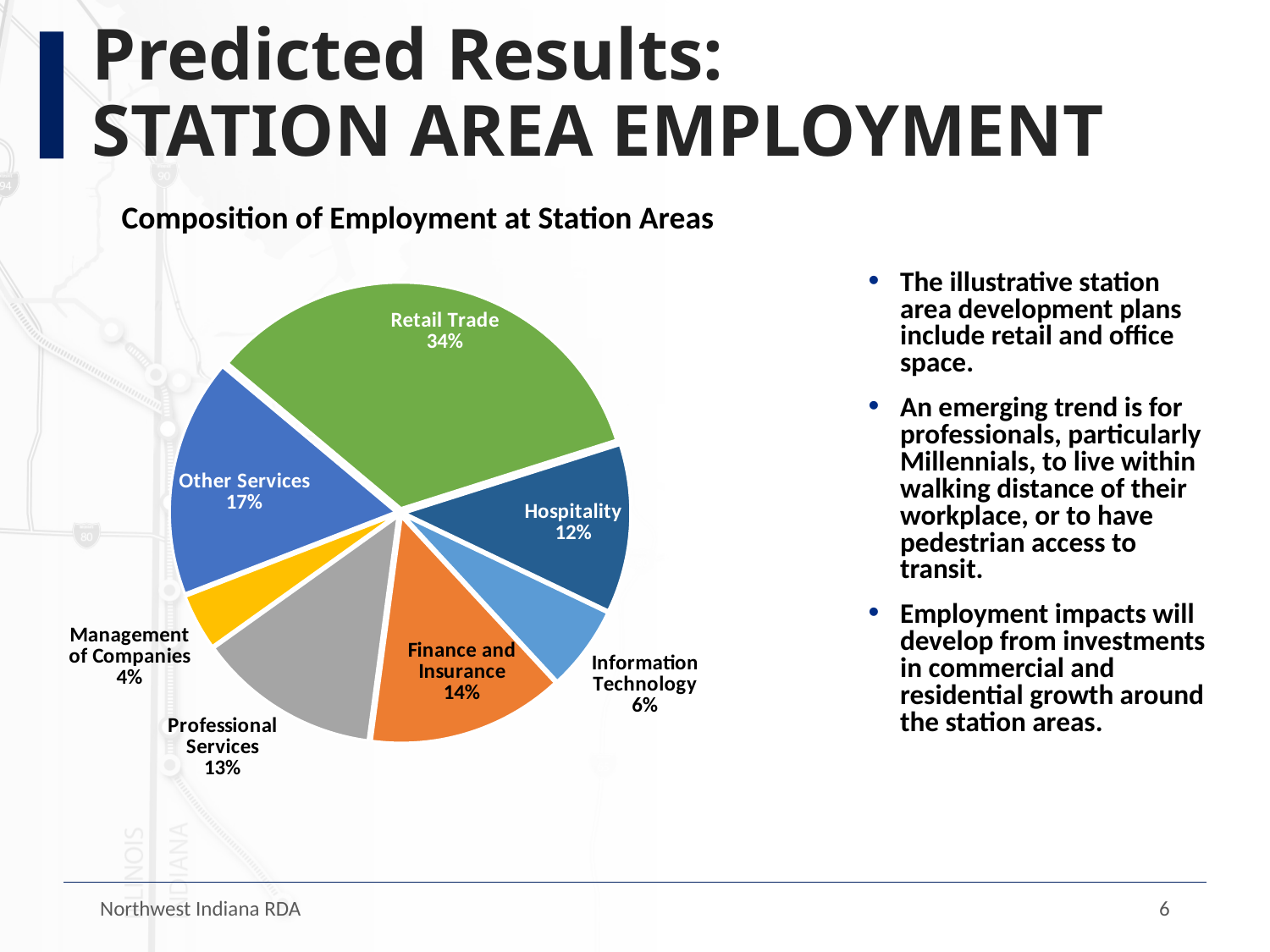
How many slices does the pie chart have? 7 What is the difference in percentage points between Retail Trade and Other Services? 17 What is the title of the chart? Composition of Employment at Station Areas What percentage is shown for Management of Companies? 4% What kind of chart is shown on the slide? Pie chart Which category has the largest share of the pie? Retail Trade What percentage is shown for Information Technology? 6% What share of employment at station areas is Retail Trade? 34% Which category has the smallest share of the pie? Management of Companies What percentage is shown for Hospitality? 12% What percentage is shown for Finance and Insurance? 14% Which is larger, Finance and Insurance or Professional Services? Finance and Insurance